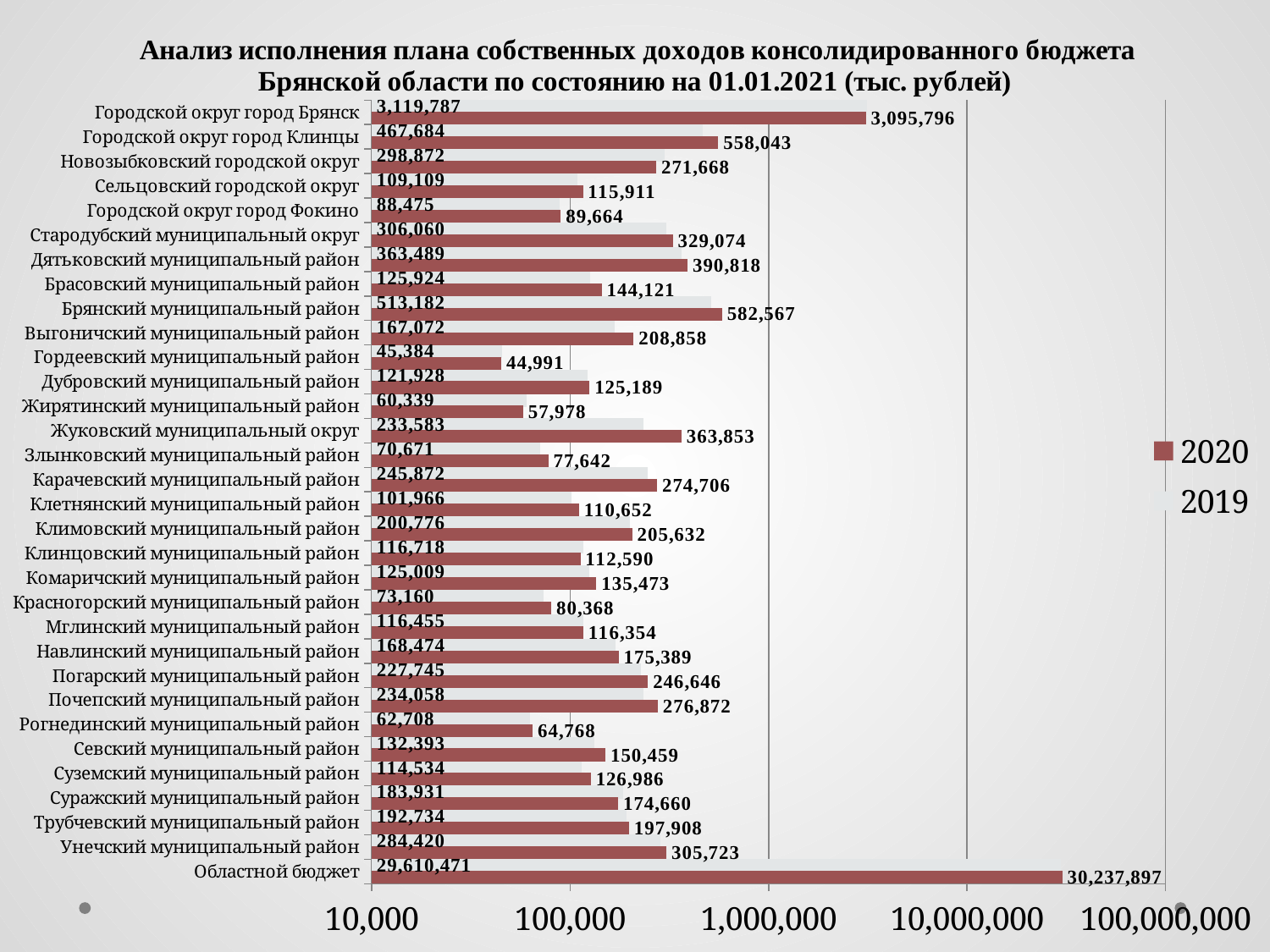
What is the 2019 value for Городской округ город Брянск? 3,119,787 What is the difference between the 2020 and 2019 values for Областной бюджет? 627,426 What is the 2020 value for Жуковский муниципальный округ? 363,853 Is the 2020 value for Гордеевский муниципальный район greater or less than 100,000? less Which category has the highest 2020 value? Областной бюджет Which category has the lowest 2020 value? Гордеевский муниципальный район How many categories are shown on the chart? 32 How many series does the legend list? 2 What is the difference between the 2020 and 2019 values for Городской округ город Клинцы? 90,359 Which has the larger 2020 value: Брянский муниципальный район or Дятьковский муниципальный район? Брянский муниципальный район What kind of chart is shown on the slide? Bar chart What is the 2020 value for Областной бюджет? 30,237,897